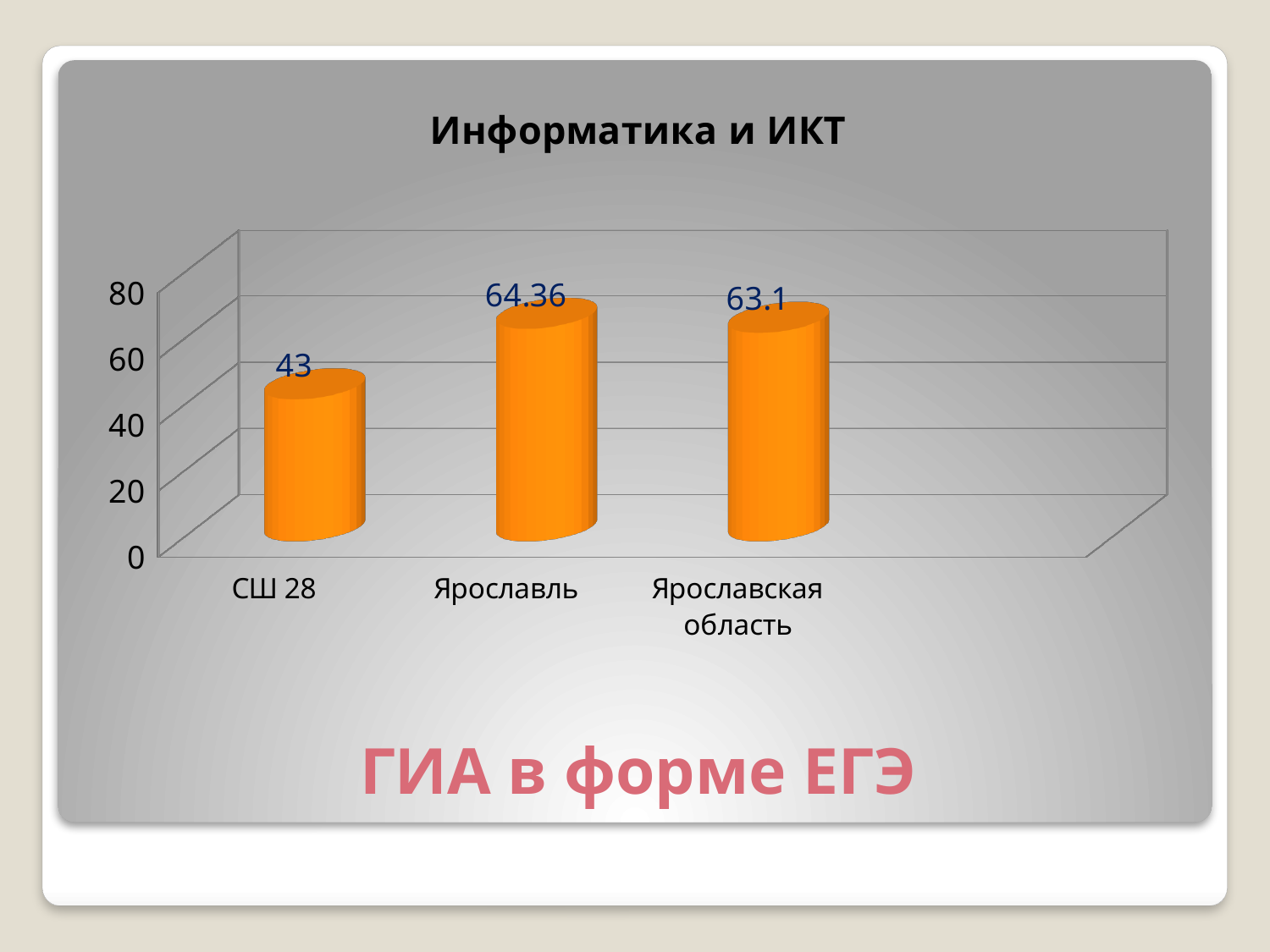
What is the value for Ярославль? 64.36 Which category has the lowest value? СШ 28 What is the difference between the values for Ярославль and СШ 28? 21.36 What kind of chart is shown on the slide? bar chart What is the value for СШ 28? 43 Which is larger, the value for СШ 28 or the value for Ярославская область? Ярославская область Which category has the highest value? Ярославль What is the value for Ярославская область? 63.1 What is the difference between the values for Ярославль and Ярославская область? 1.26 Is the value for СШ 28 greater or less than 60? less How many categories are shown on the chart? 3 What is the title of the chart? Информатика и ИКТ